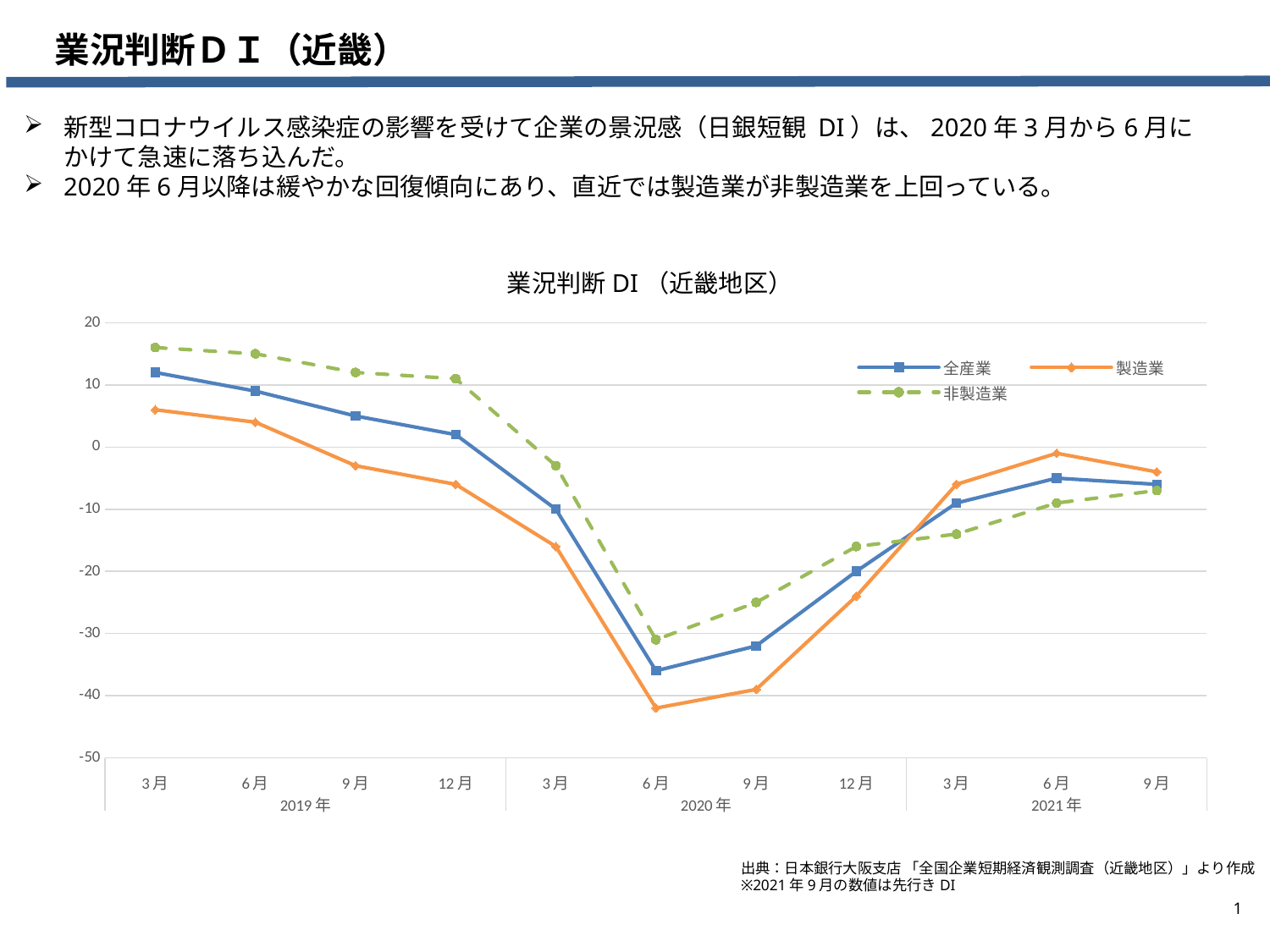
Is the value for 非製造業 in 2019年3月 greater or less than 10? greater Is the value for 製造業 in 2020年9月 greater or less than -30? less Is the value for 製造業 in 2020年6月 greater or less than -40? less In 2019年3月, which is higher, 製造業 or 非製造業? 非製造業 How many time points are plotted along the x axis of the chart? 11 Which series is drawn with a dashed green line? 非製造業 At which time point does the 製造業 series reach its lowest value? 2020年6月 What kind of chart is shown on the slide? line chart In 2021年9月, which is higher, 製造業 or 非製造業? 製造業 How many series does the chart legend list? 3 What is the title of the chart? 業況判断DI（近畿地区）